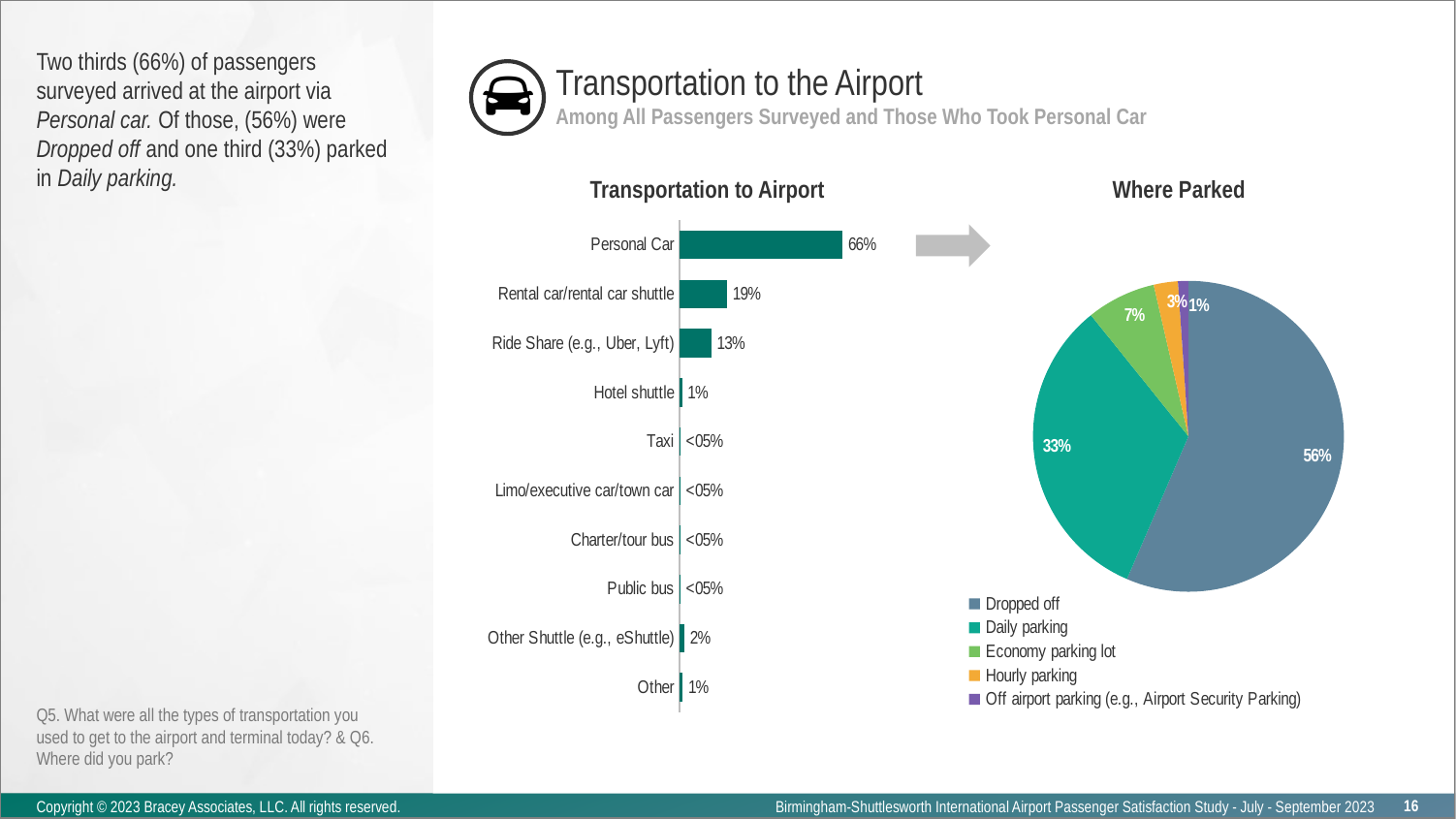
How many entries does the legend of the "Where Parked" chart list? 5 In the "Where Parked" chart, which category has the smallest share? Off airport parking (e.g., Airport Security Parking) In the "Transportation to Airport" chart, what percentage of passengers arrived by Personal Car? 66% In the "Transportation to Airport" chart, which category has the highest value? Personal Car What kind of chart is the "Transportation to Airport" chart? Bar chart In the "Where Parked" chart, what share of passengers were Dropped off? 56% In the "Where Parked" chart, what is the value for Daily parking? 33% In the "Transportation to Airport" chart, what is the value for Rental car/rental car shuttle? 19% In the "Transportation to Airport" chart, what is the value for Ride Share (e.g., Uber, Lyft)? 13% How many categories are shown in the "Transportation to Airport" chart? 10 In the "Transportation to Airport" chart, which is larger: Ride Share (e.g., Uber, Lyft) or Other Shuttle (e.g., eShuttle)? Ride Share (e.g., Uber, Lyft) In the "Transportation to Airport" chart, what is the difference between Personal Car and Rental car/rental car shuttle? 47%